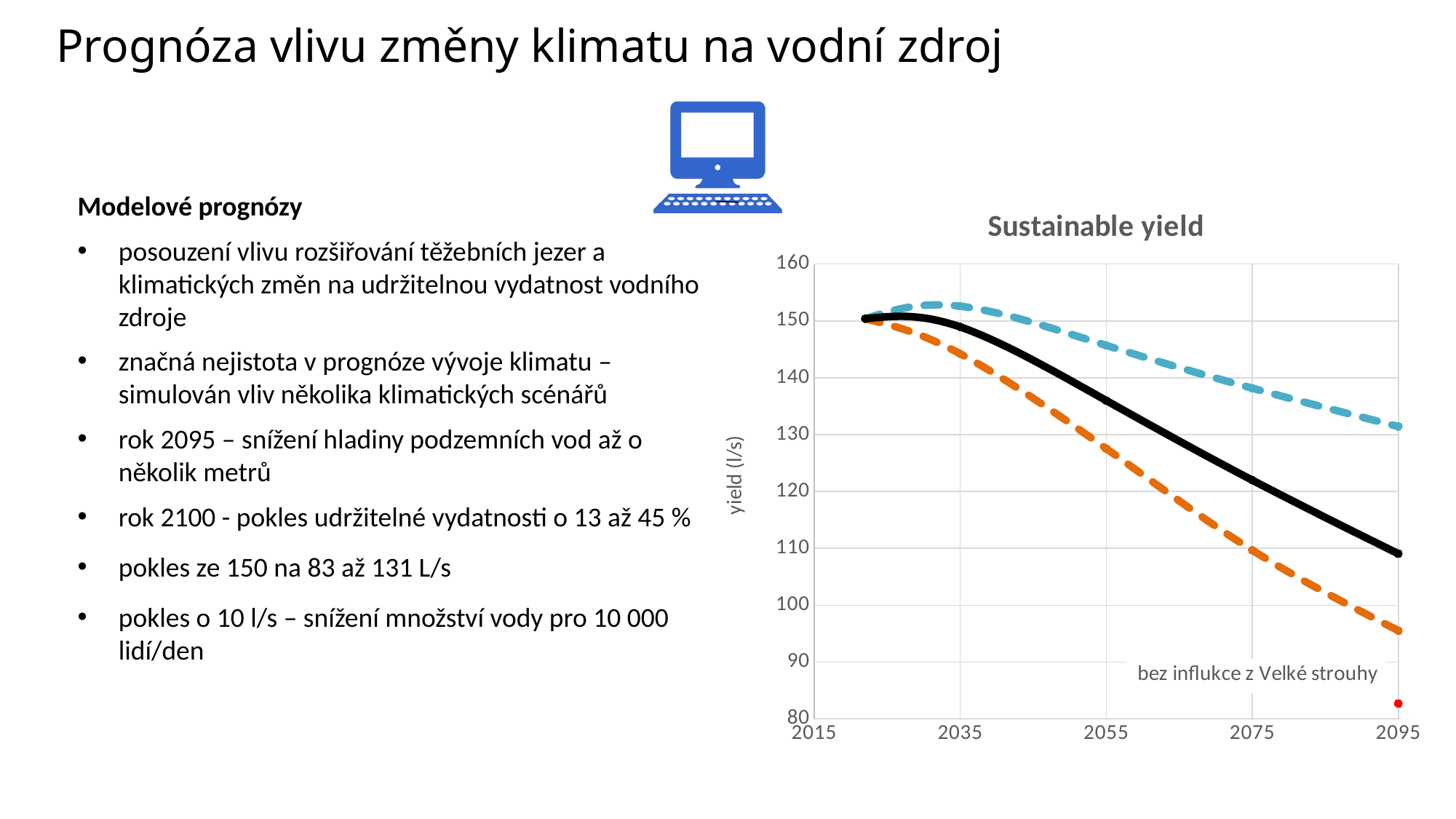
What is the label of the vertical axis of the chart? yield (l/s) Is the value of the black solid line at 2095 greater or less than 120? less Does the black solid line rise or fall from 2035 to 2095? fall How many lines are plotted in the chart? 3 Does the orange dashed line rise or fall along the x axis? fall What type of chart is shown on the slide? line chart Is the value of the orange dashed line at 2095 greater or less than 100? less What is the title of the chart? Sustainable yield Is the value of the blue dashed line at 2055 greater or less than 140? greater At 2095, which line has the higher value: the blue dashed line or the orange dashed line? blue dashed line Which line has the lowest value at 2095? orange dashed line